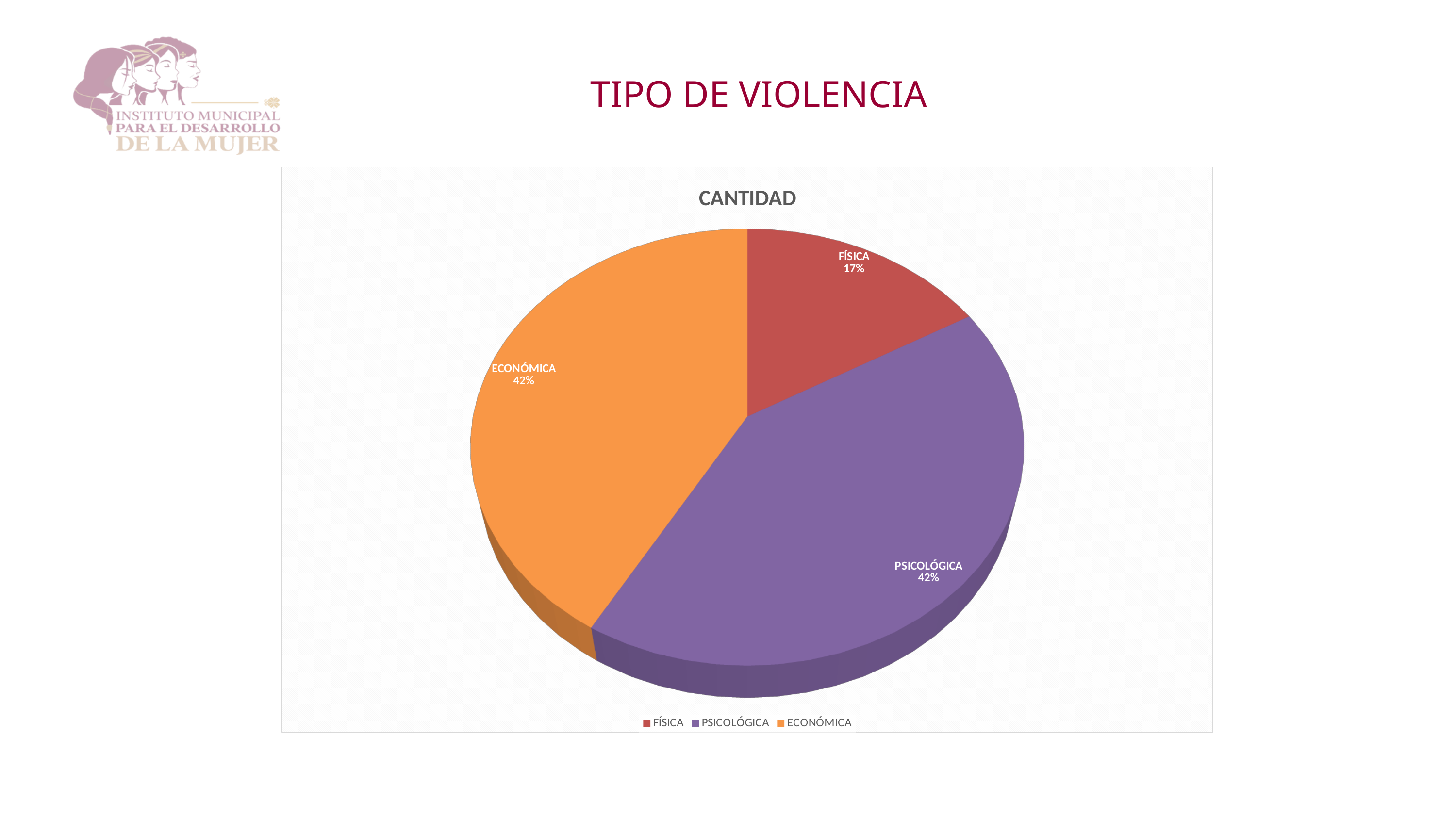
How many entries are listed in the legend? 3 What percentage does the ECONÓMICA slice represent? 42% What is the difference in percentage points between the ECONÓMICA and FÍSICA slices? 25 What is the title of the chart? CANTIDAD What percentage does the PSICOLÓGICA slice represent? 42% Which type of violence has the smallest share of the pie? FÍSICA What kind of chart is shown on the slide? Pie chart How many slices does the pie chart have? 3 What colour is the PSICOLÓGICA slice? Purple Which is larger, the share for FÍSICA or the share for PSICOLÓGICA? PSICOLÓGICA What percentage does the FÍSICA slice represent? 17% What share of the pie does ECONÓMICA account for? 42%